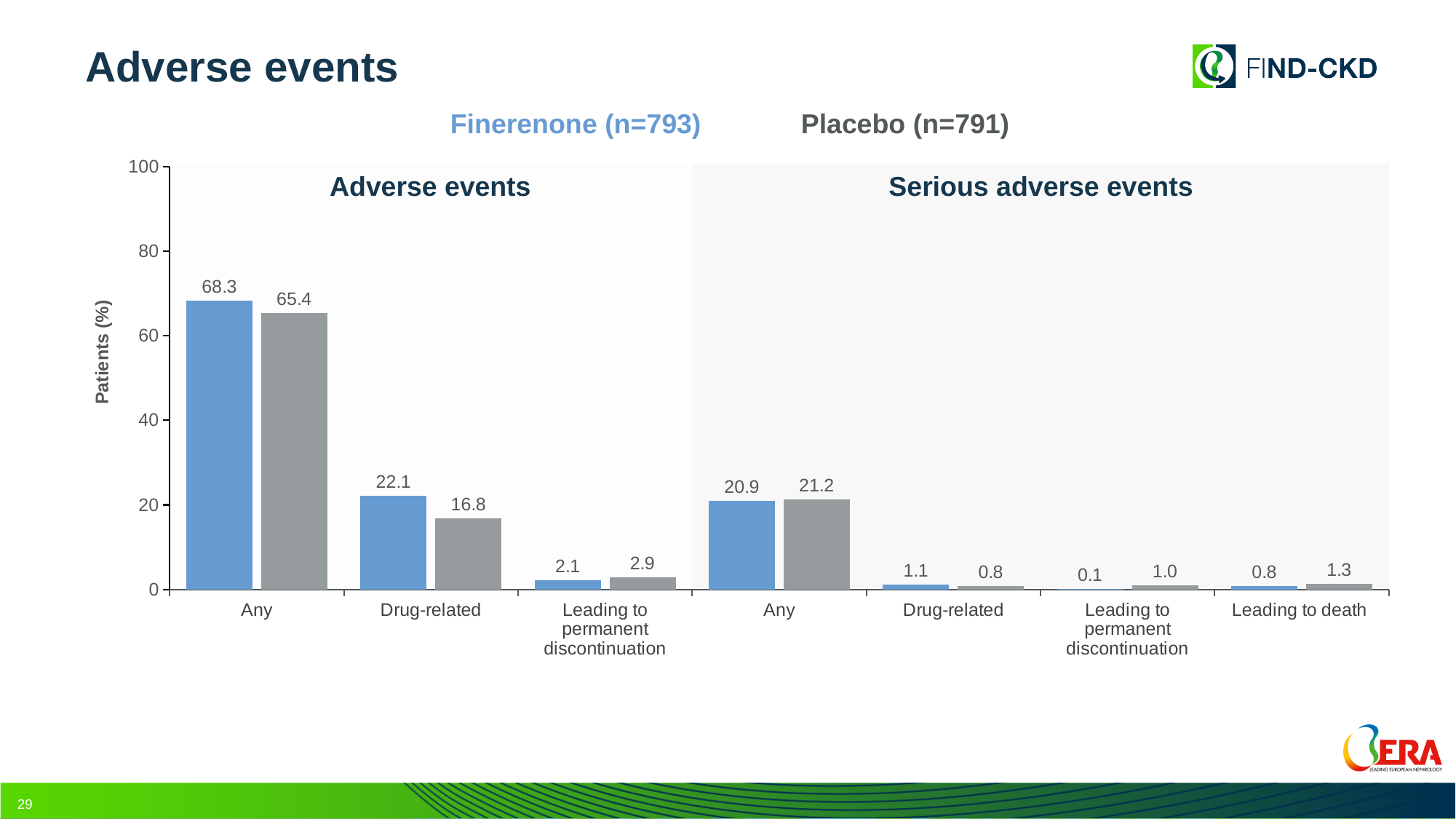
Which category has the lowest value for Finerenone? Leading to permanent discontinuation (serious adverse events) What is the difference between Finerenone and Placebo for any adverse event? 2.9 What is the difference between Finerenone and Placebo for drug-related adverse events? 5.3 What percentage of Placebo patients had a drug-related adverse event? 16.8 What percentage of Finerenone patients had any adverse event? 68.3 Is the Placebo value for any adverse event greater or less than 60? greater How many series does the chart show? 2 What type of chart is shown on the slide? Bar chart Which category has the highest value for Finerenone? Any (adverse events) What is the value for Placebo for serious adverse events leading to death? 1.3 What is the value for Finerenone for serious adverse events leading to permanent discontinuation? 0.1 For adverse events leading to permanent discontinuation, which is larger, Finerenone or Placebo? Placebo